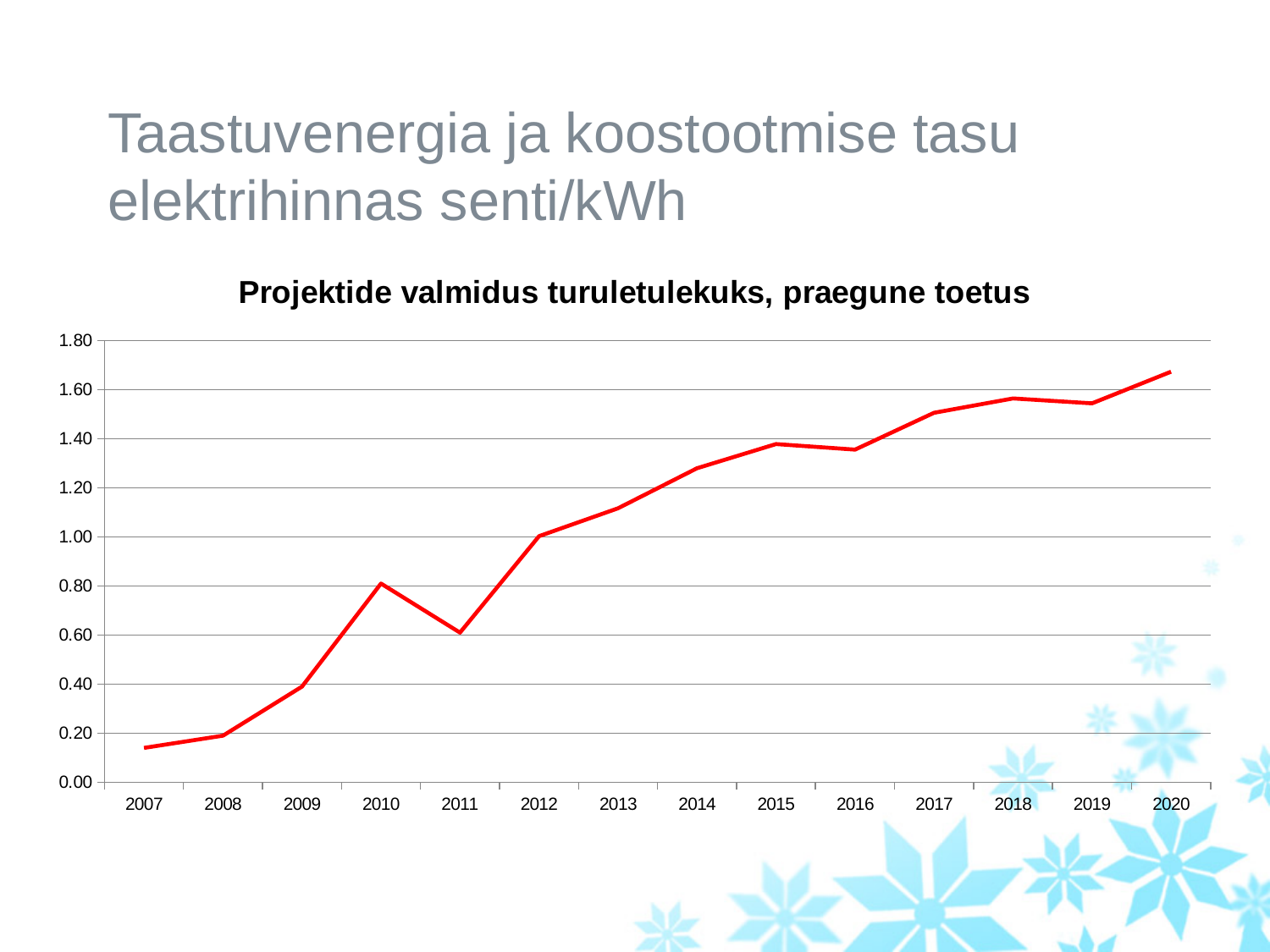
Do the values generally rise or fall from 2007 to 2020? rise What colour is the line on the chart? red Is the value for 2017 greater or less than 1.40? greater Which year has the larger value, 2010 or 2011? 2010 Which year has the highest value on the chart? 2020 Is the value for 2007 greater or less than 0.20? less What is the title of the chart? Projektide valmidus turuletulekuks, praegune toetus Is the value for 2011 greater or less than 0.80? less What kind of chart is shown on the slide? line chart Which year has the lowest value on the chart? 2007 How many years are plotted on the x axis of the chart? 14